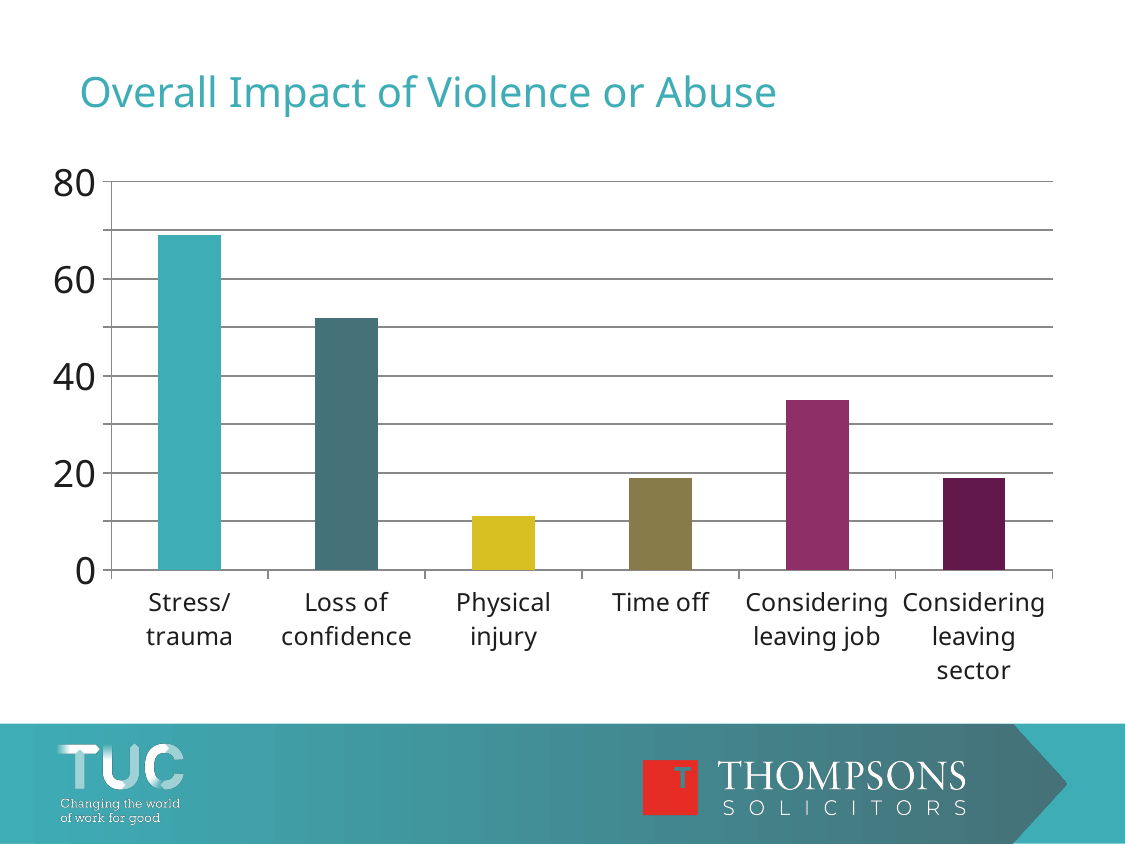
Which is larger, the value for Loss of confidence or the value for Considering leaving job? Loss of confidence Is the value for Stress/trauma greater or less than 60? greater Which category has the highest value? Stress/trauma Which is larger, the value for Physical injury or the value for Considering leaving sector? Considering leaving sector How many categories are shown on the x axis of the chart? 6 What kind of chart is shown on the slide? bar chart Which category has the lowest value? Physical injury Is the value for Physical injury greater or less than 20? less Is the value for Considering leaving job greater or less than 40? less What is the title of the chart? Overall Impact of Violence or Abuse